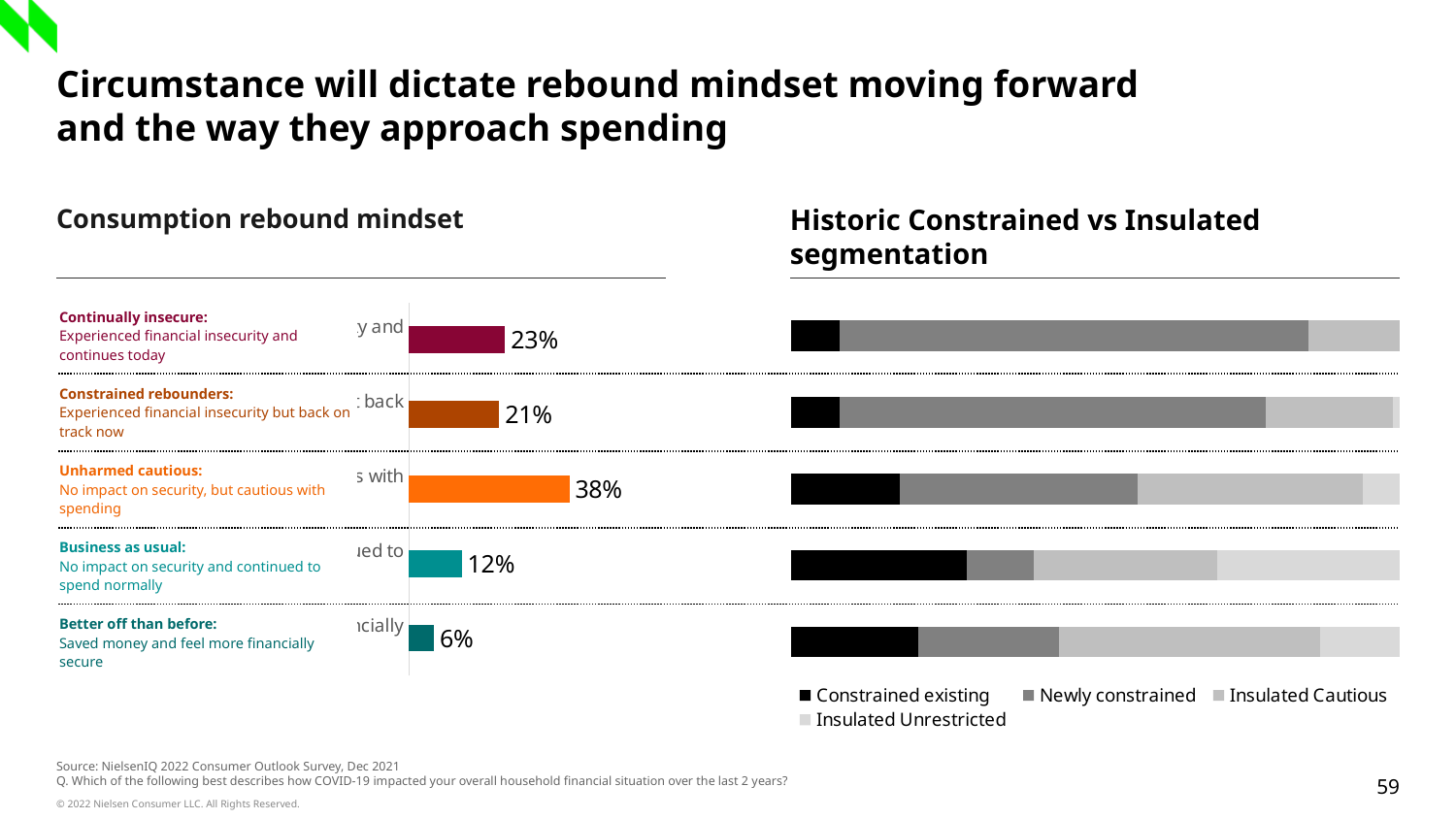
In the Consumption rebound mindset chart, which category has the lowest value? Better off than before In the Consumption rebound mindset chart, what is the value for Unharmed cautious? 38% In the Consumption rebound mindset chart, what is the value for Better off than before? 6% In the Consumption rebound mindset chart, what is the value for Business as usual? 12% In the Consumption rebound mindset chart, what is the value for Continually insecure? 23% How many categories are shown in the Consumption rebound mindset chart? 5 In the Consumption rebound mindset chart, which category has the highest value? Unharmed cautious What kind of chart is the Consumption rebound mindset chart? Bar chart In the Consumption rebound mindset chart, which is larger: Continually insecure or Constrained rebounders? Continually insecure How many series does the legend of the Historic Constrained vs Insulated segmentation chart list? 4 In the Consumption rebound mindset chart, what is the difference between Unharmed cautious and Constrained rebounders? 17% In the Historic Constrained vs Insulated segmentation chart, which series is shown in black? Constrained existing